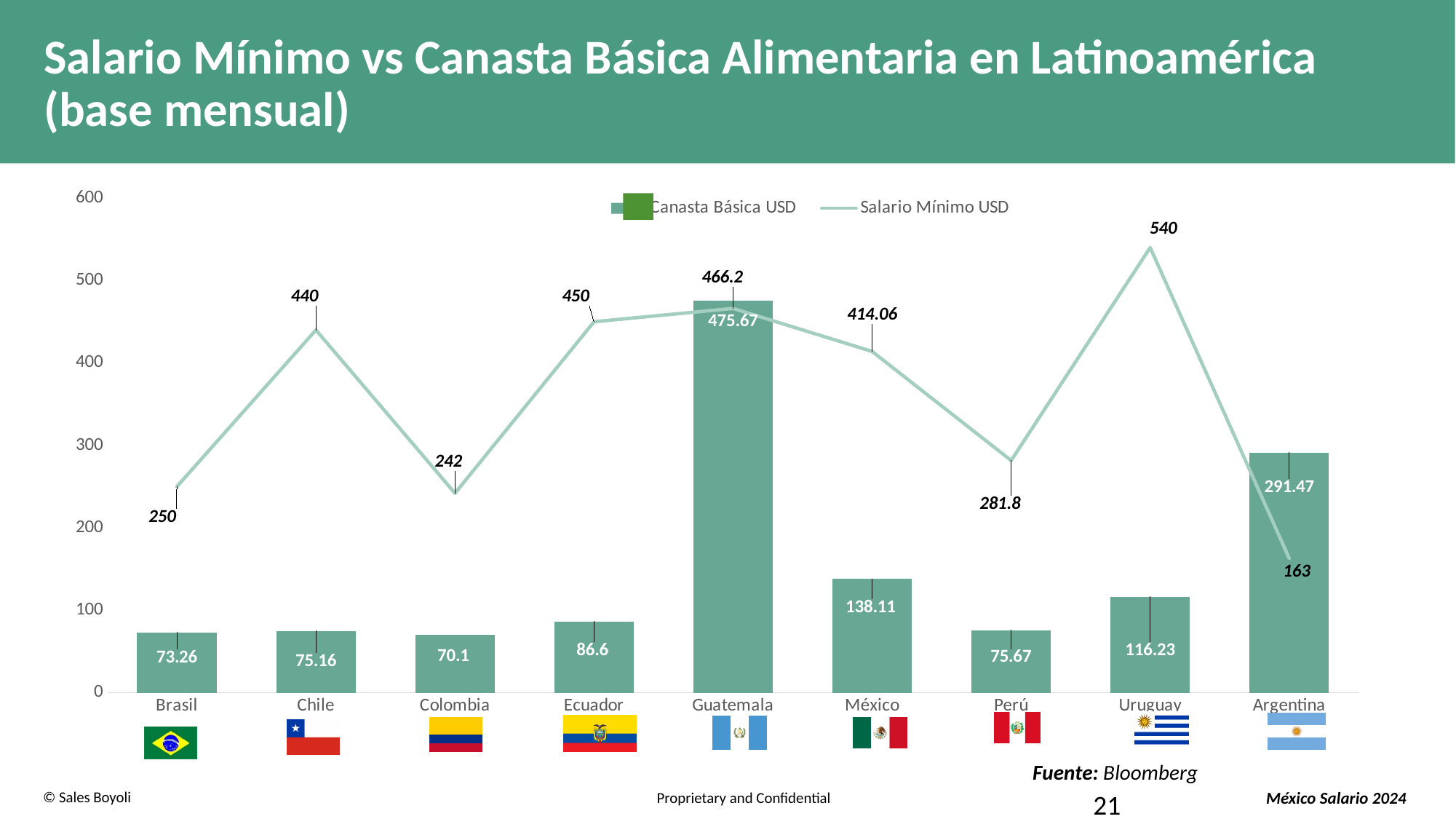
Which country has the lowest Salario Mínimo USD? Argentina Which country has the lowest Canasta Básica USD? Colombia What is the Canasta Básica USD value for México? 138.11 Which country has the highest Salario Mínimo USD? Uruguay What is the Salario Mínimo USD value for Colombia? 242 What is the Canasta Básica USD value for Guatemala? 475.67 Which is larger for Guatemala, the Canasta Básica USD or the Salario Mínimo USD? Canasta Básica USD How many series does the legend list? 2 What is the Salario Mínimo USD value for Uruguay? 540 What kind of chart is shown on the slide? Combined bar and line chart What is the difference between the Salario Mínimo USD and the Canasta Básica USD for Argentina? 128.47 How many countries are shown on the x axis? 9